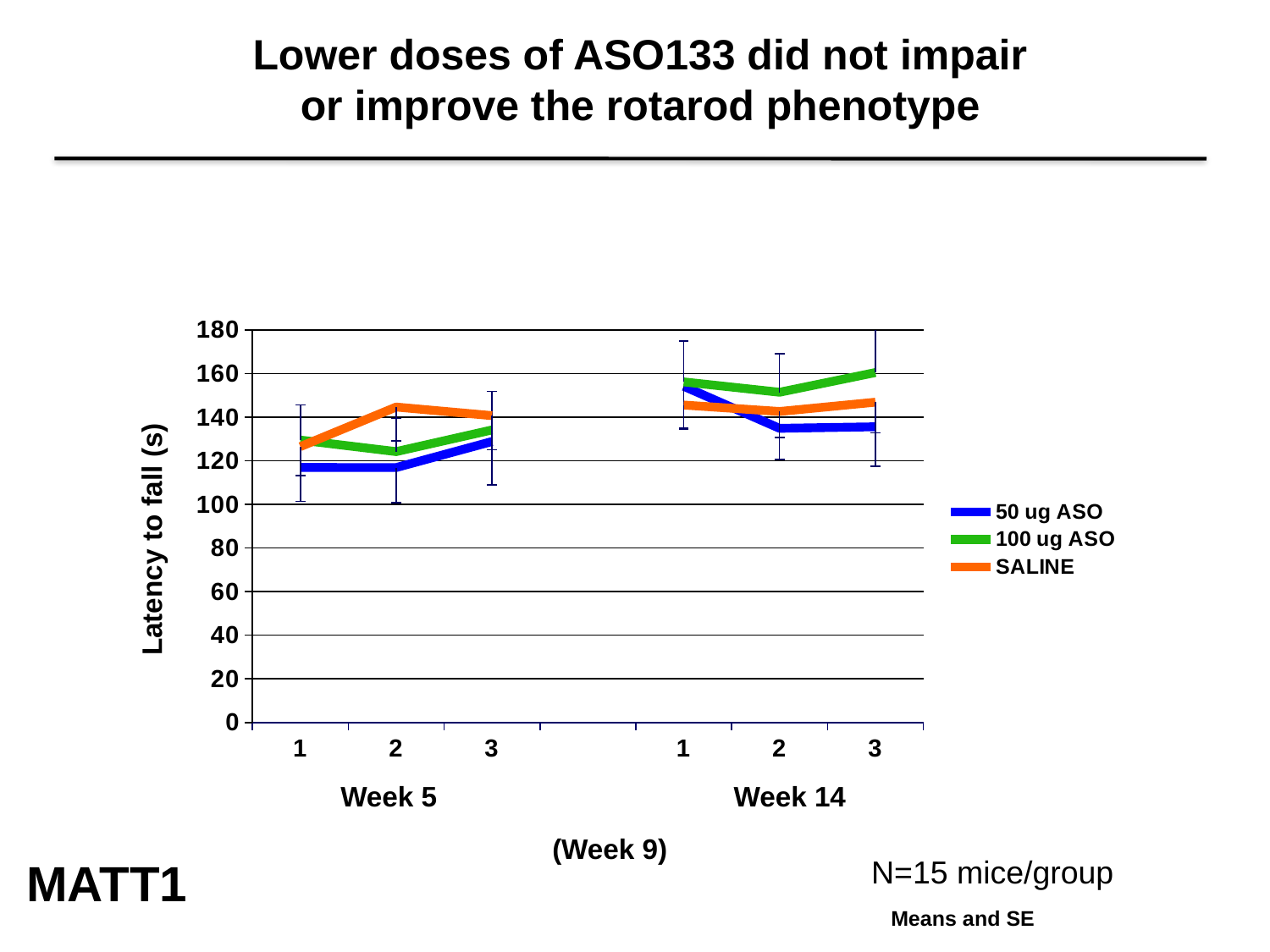
Is the value for 100 ug ASO at Week 5 trial 2 greater or less than 140? less Does the 50 ug ASO line rise or fall from trial 2 to trial 3 in Week 5? rise What is the label on the y axis? Latency to fall (s) What kind of chart is shown on the slide? line chart Is the value for 50 ug ASO at Week 5 trial 1 greater or less than 100? greater What are the three series named in the legend? 50 ug ASO, 100 ug ASO, SALINE How many series does the legend list? 3 Is the value for 100 ug ASO at Week 14 trial 3 greater or less than 140? greater How many trials are plotted for each week on the x axis? 3 At Week 5 trial 2, which series has the higher value, SALINE or 50 ug ASO? SALINE At Week 14 trial 3, which series has the higher value, 50 ug ASO or 100 ug ASO? 100 ug ASO